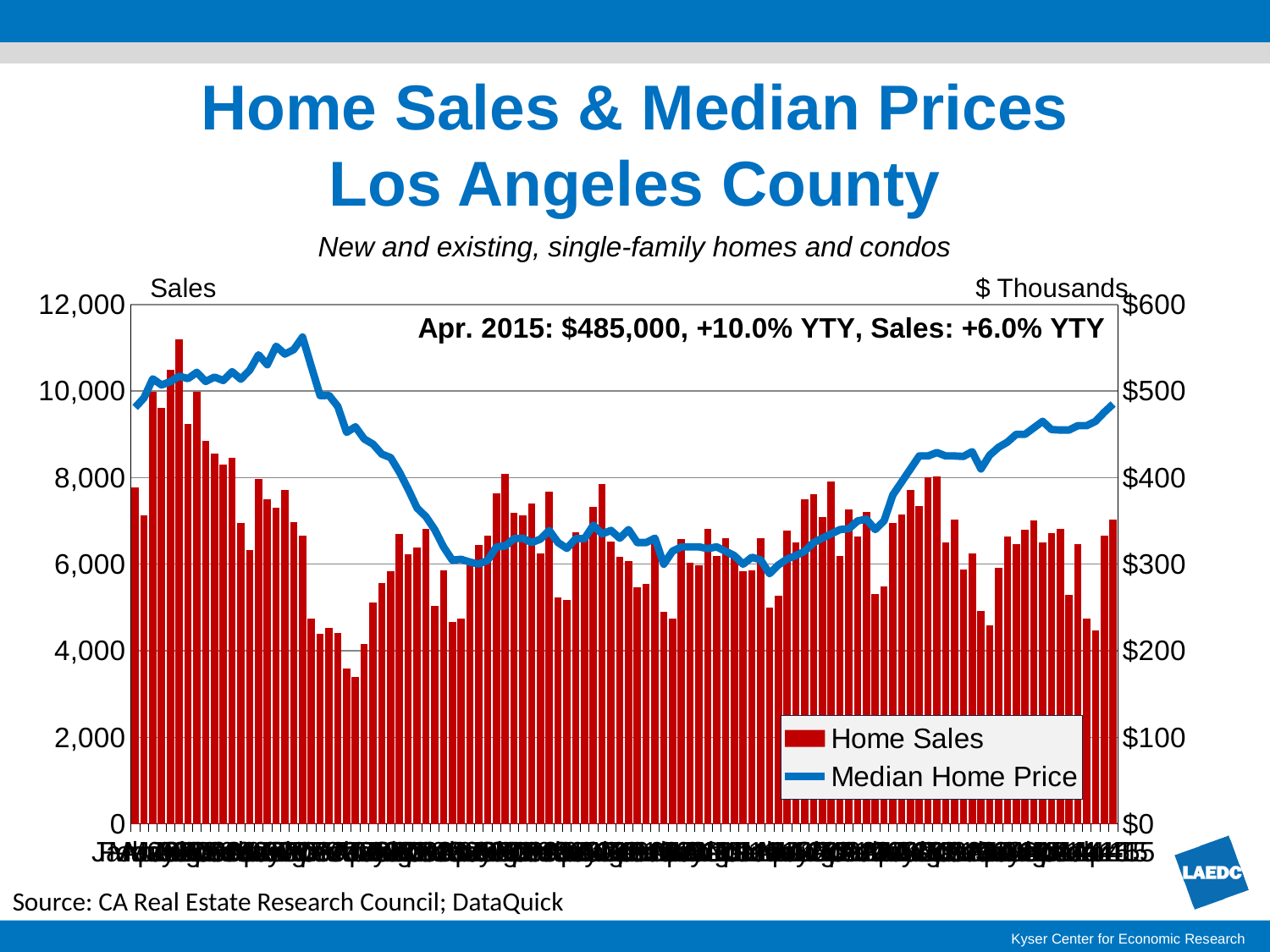
Which series is drawn as red bars? Home Sales According to the annotation, what was the year-to-year change in sales in Apr. 2015? +6.0% YTY According to the annotation, what was the year-to-year change in the median home price in Apr. 2015? +10.0% YTY What is the maximum value shown on the right-hand ($ Thousands) axis? $600 How many series does the legend list? 2 Is the shortest Home Sales bar greater or less than 4,000? less Is the tallest Home Sales bar greater or less than 10,000? greater What is the label on the left vertical axis? Sales What kind of chart is shown on the slide? A combination of a bar chart and a line chart According to the annotation, what was the median home price in Apr. 2015? $485,000 Is the lowest point of the Median Home Price line greater or less than $400 thousand? less